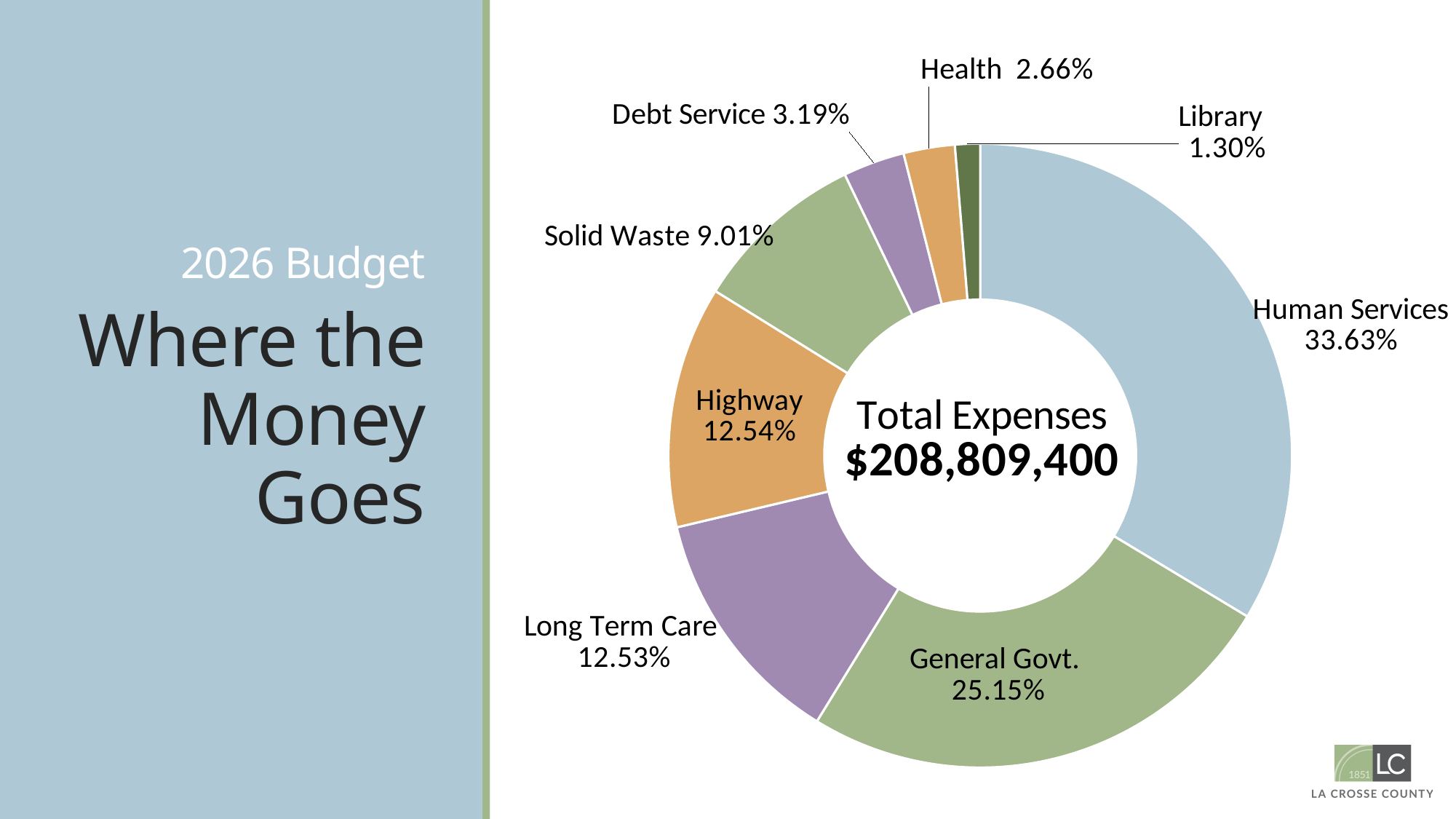
How many expense categories are shown in the chart? 8 Which category has the largest share of total expenses? Human Services What share of total expenses goes to Human Services? 33.63% What is the percentage shown for Solid Waste? 9.01% What kind of chart is shown on the slide? doughnut chart What percentage is shown for Debt Service? 3.19% What share of expenses goes to the Library? 1.30% Which category has the smallest share of total expenses? Library What percentage of the budget is allocated to General Govt.? 25.15% What total expenses amount is shown in the center of the chart? $208,809,400 Which has a larger share, Highway or Long Term Care? Highway What is the difference in percentage points between Human Services and General Govt.? 8.48